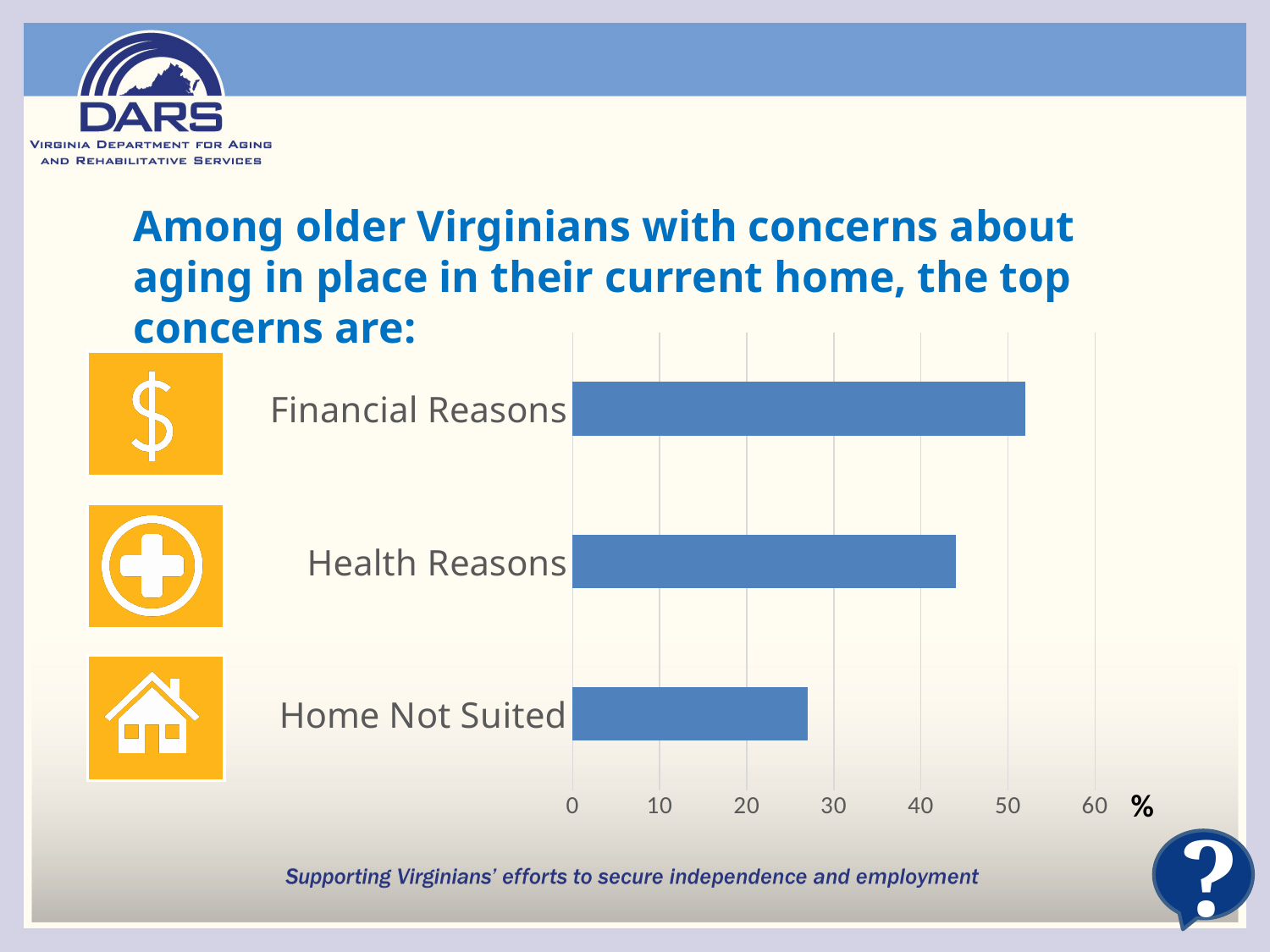
Which concern has the highest value in the chart? Financial Reasons Is the value for Home Not Suited greater or less than 30? less Which is larger, the value for Health Reasons or the value for Home Not Suited? Health Reasons What unit is shown at the end of the horizontal axis? % How many categories does the chart show? 3 Is the value for Health Reasons greater or less than 50? less Which concern has the lowest value in the chart? Home Not Suited Which is larger, the value for Financial Reasons or the value for Health Reasons? Financial Reasons Is the value for Health Reasons greater or less than 40? greater What kind of chart is shown on the slide? bar chart